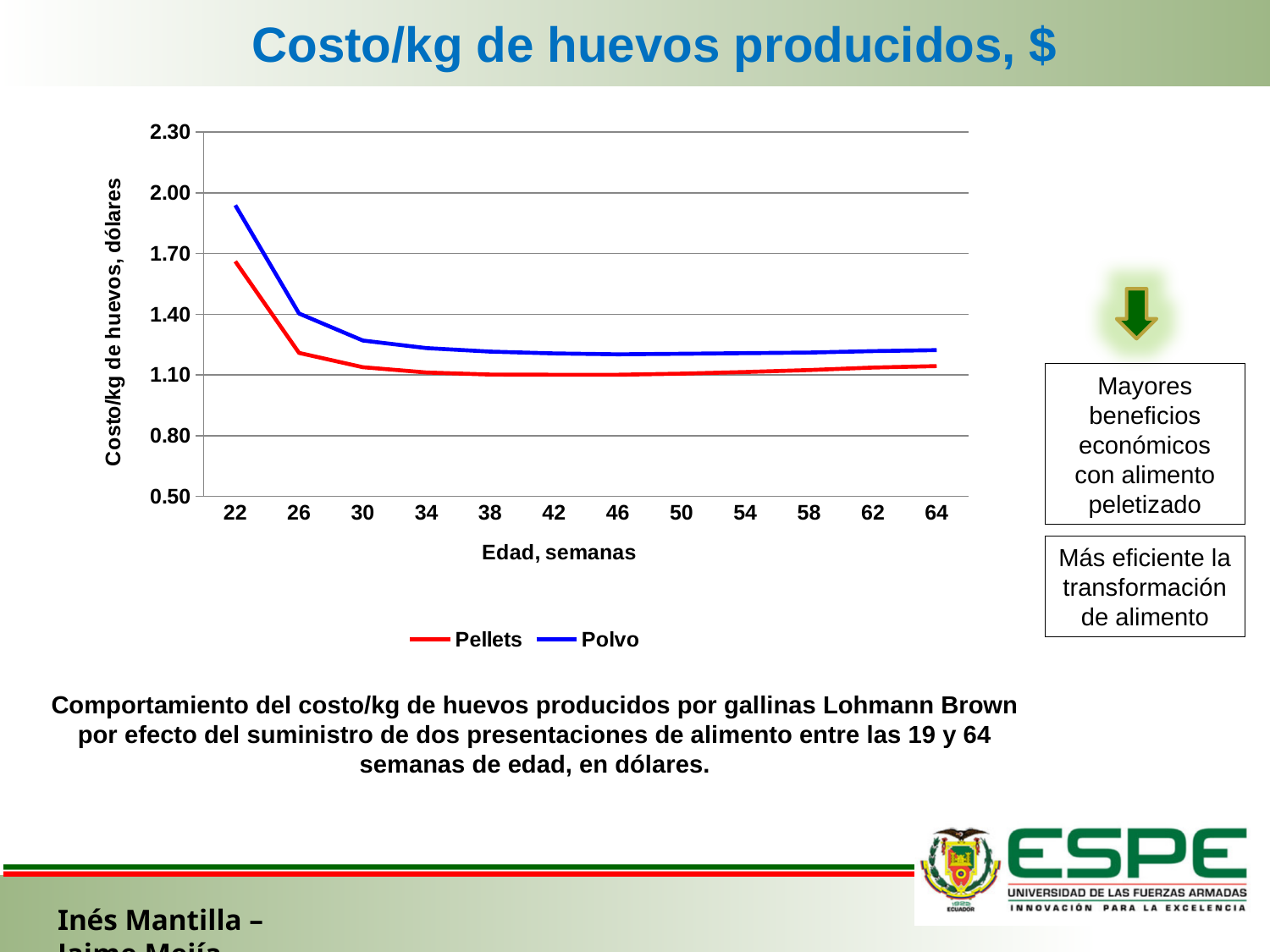
Do the Pellets values rise or fall between 22 and 38 weeks? fall Is the value for Pellets at 22 weeks greater or less than 1.40? greater What kind of chart is shown on the slide? line chart At which age in weeks does the Polvo series reach its highest value? 22 Is the value for Polvo at 46 weeks greater or less than 1.10? greater At 22 weeks, which series has the higher cost, Pellets or Polvo? Polvo Is the value for Polvo at 22 weeks greater or less than 1.70? greater How many age points (weeks) are shown along the x axis? 12 How many series does the legend list? 2 What colour is the Pellets line? red What is the label of the x axis? Edad, semanas